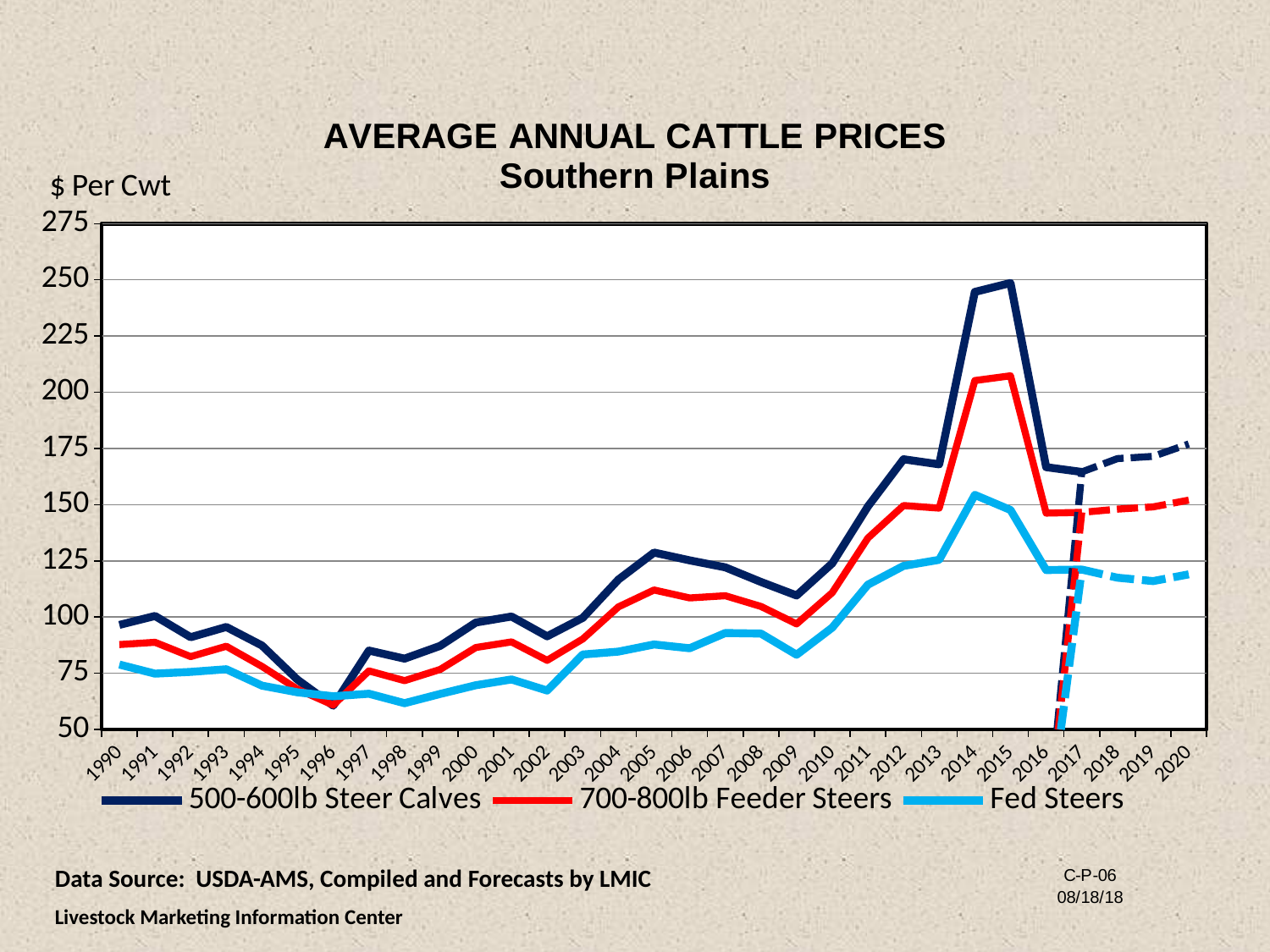
Is the value for 500-600lb Steer Calves in 2015 greater or less than 225? greater Is the value for 700-800lb Feeder Steers in 1996 greater or less than 75? less How many years are shown along the x axis? 31 Is the value for 500-600lb Steer Calves in 2005 greater or less than 100? greater What unit label is shown on the y axis? $ Per Cwt What kind of chart is shown on the slide? Line chart Do the Fed Steers values rise or fall from 2009 to 2014? rise In which year does the Fed Steers series reach its highest value? 2014 In 2015, which series is higher: 500-600lb Steer Calves or Fed Steers? 500-600lb Steer Calves How many series does the legend list? 3 In which year does the 700-800lb Feeder Steers series reach its lowest value? 1996